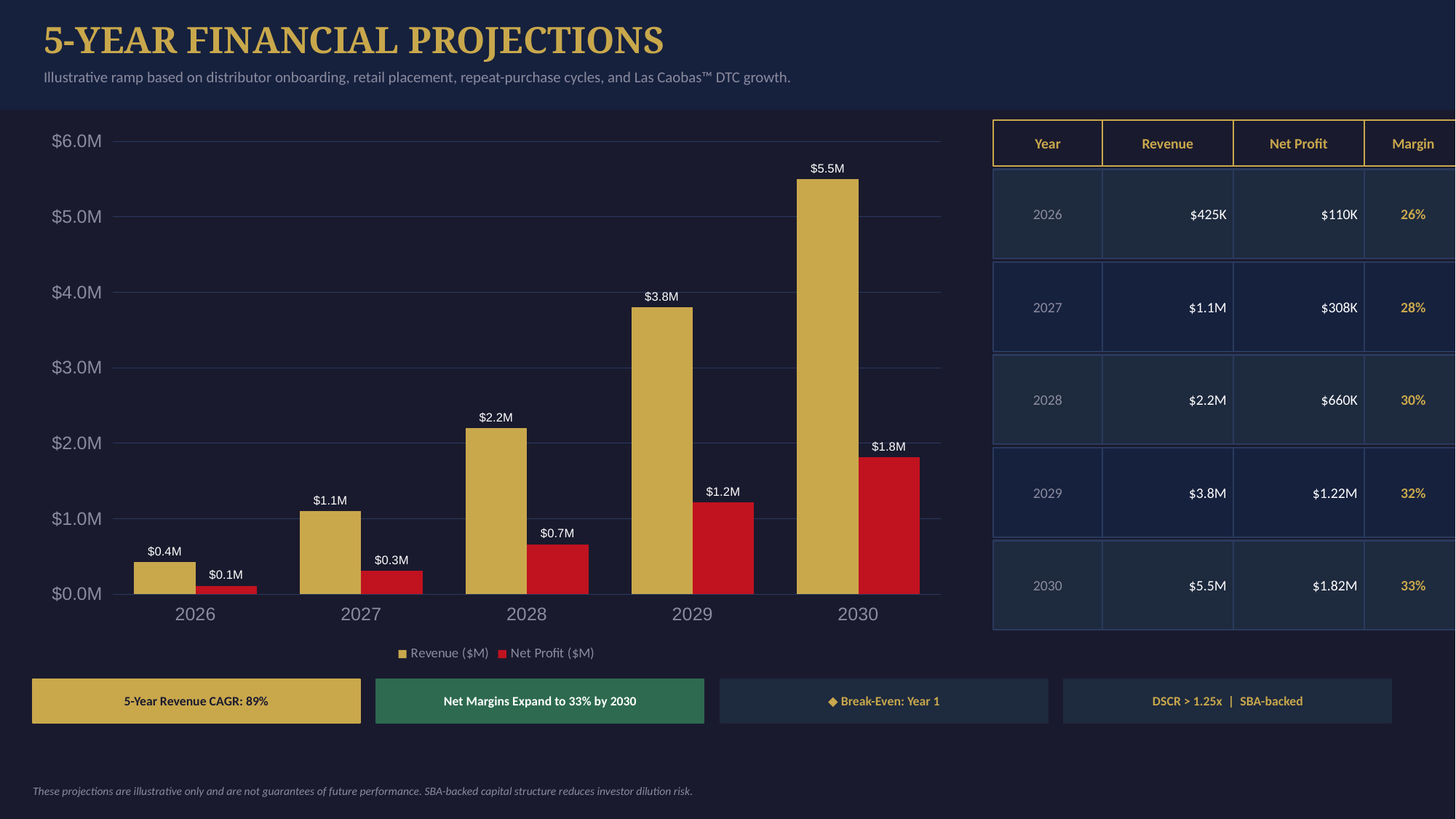
What kind of chart is shown on the slide? bar chart Which year has the highest Revenue ($M) in the chart? 2030 How many years are shown on the x axis of the chart? 5 What is the Net Profit ($M) value for 2029 in the chart? $1.2M Which is larger in the chart: Revenue ($M) for 2027 or Net Profit ($M) for 2029? Net Profit ($M) for 2029 Is the Revenue ($M) value for 2029 greater or less than $3.0M? greater What is the Revenue ($M) value for 2028 in the chart? $2.2M How many series does the chart legend list? 2 What is the Net Profit ($M) value for 2026 in the chart? $0.1M Which year has the lowest Net Profit ($M) in the chart? 2026 Do the Revenue ($M) values rise or fall from 2026 to 2030 in the chart? rise What is the difference between Revenue ($M) and Net Profit ($M) for 2030 in the chart? $3.7M